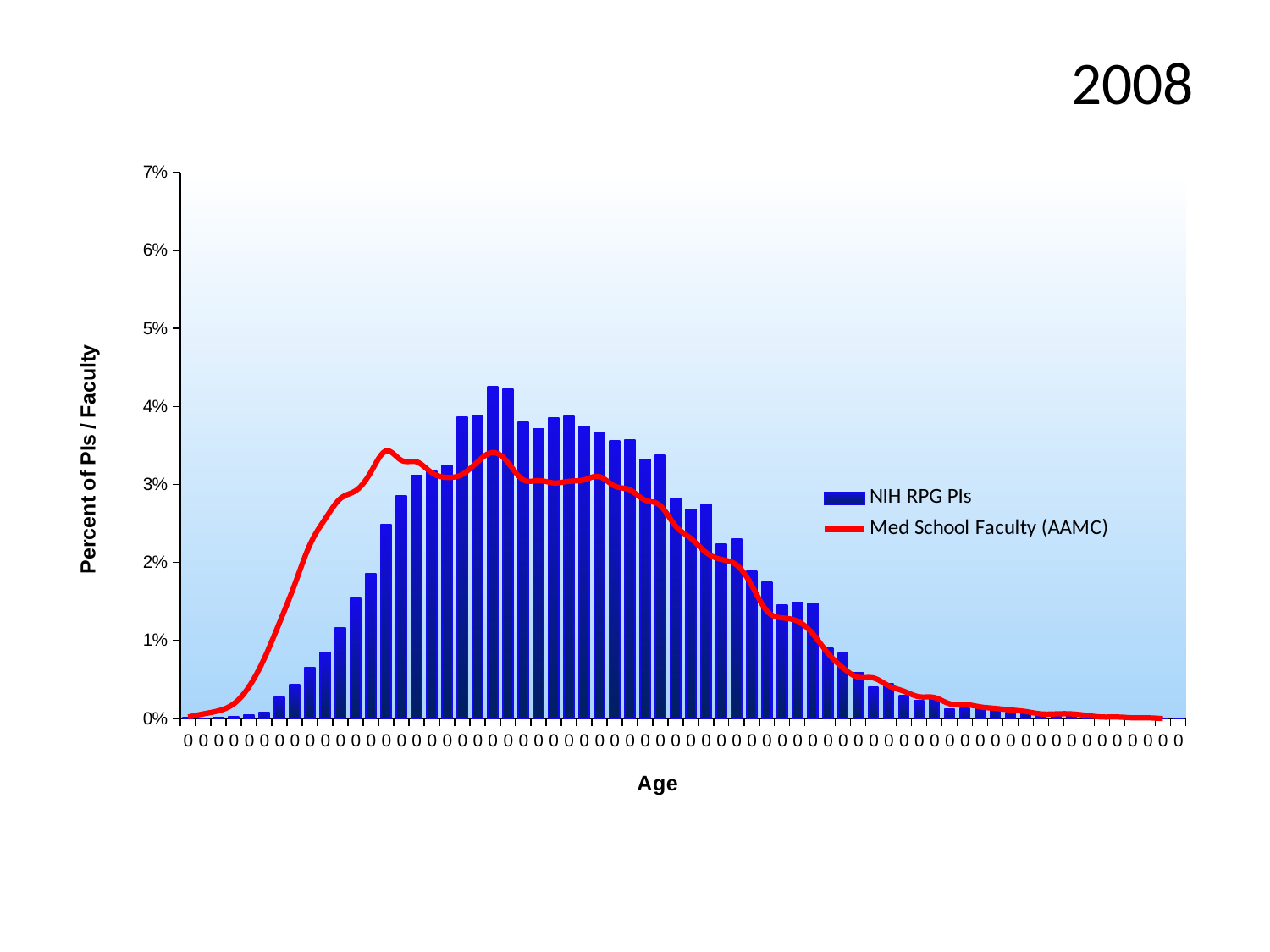
Is the highest point of the Med School Faculty (AAMC) line greater or less than 4%? less Which series reaches a higher peak value, NIH RPG PIs or Med School Faculty (AAMC)? NIH RPG PIs Do the Med School Faculty (AAMC) values rise or fall along the left-hand portion of the x axis, before the line's first peak? rise How many series does the legend list? 2 What is the label of the vertical axis? Percent of PIs / Faculty What kind of chart is shown on the slide? A bar chart combined with a line Is the tallest NIH RPG PIs bar greater or less than 4%? greater Which series is drawn as bars? NIH RPG PIs Is the highest point of the Med School Faculty (AAMC) line greater or less than 3%? greater Do the NIH RPG PIs values rise or fall along the right-hand half of the x axis? fall